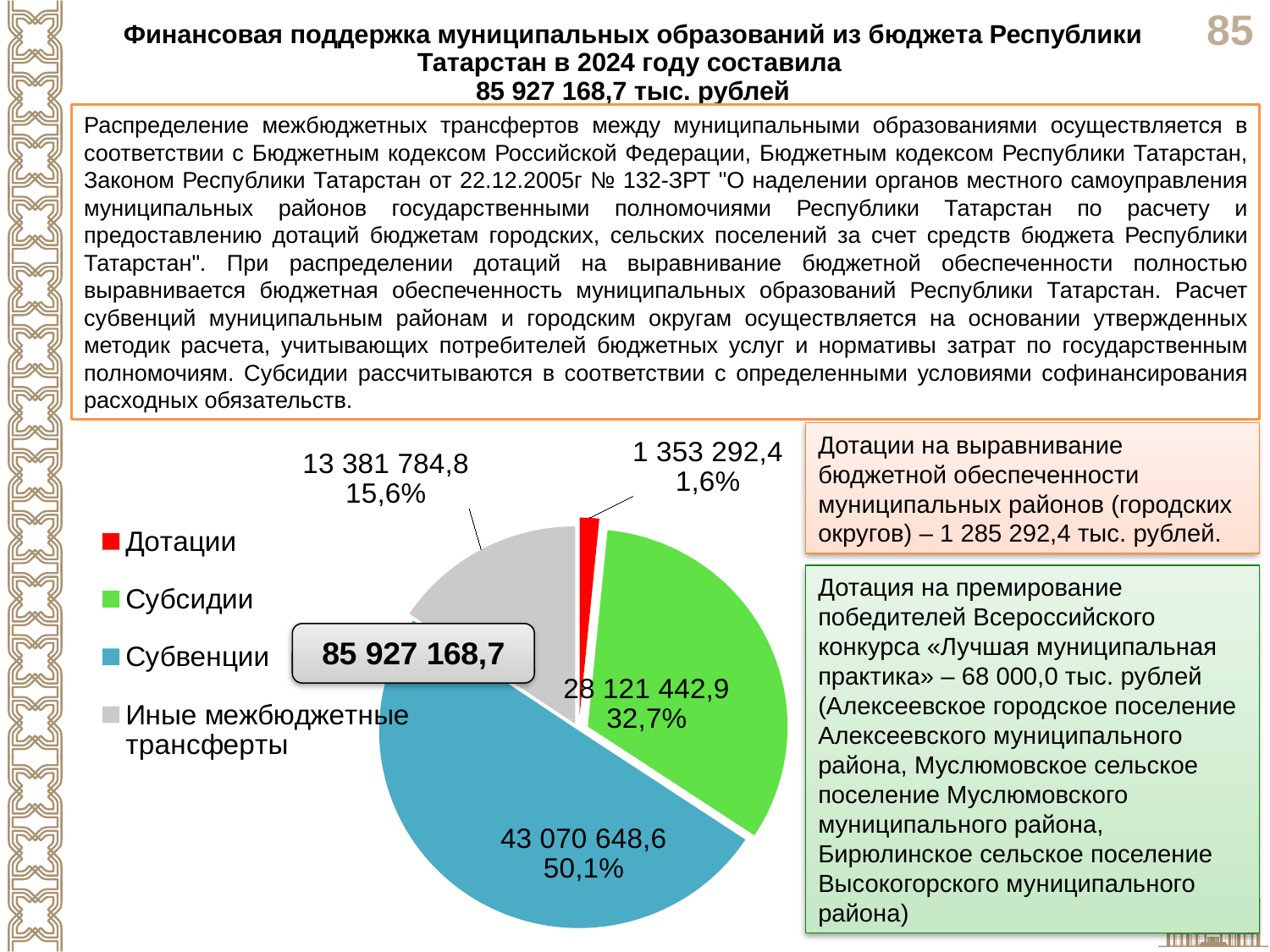
What is the value shown for Субвенции in the pie chart? 43 070 648,6 Which category has the smallest slice in the pie chart? Дотации What colour is the slice for Субвенции in the pie chart? blue What share of the pie does Иные межбюджетные трансферты represent? 15,6% Which category has the largest slice in the pie chart? Субвенции How many entries does the legend of the pie chart list? 4 How many slices does the pie chart have? 4 What is the value shown for Дотации in the pie chart? 1 353 292,4 What share of the pie does Субвенции represent? 50,1% What kind of chart is shown on the slide? pie chart What is the value shown for Субсидии in the pie chart? 28 121 442,9 Which is larger in the pie chart, Субсидии or Иные межбюджетные трансферты? Субсидии